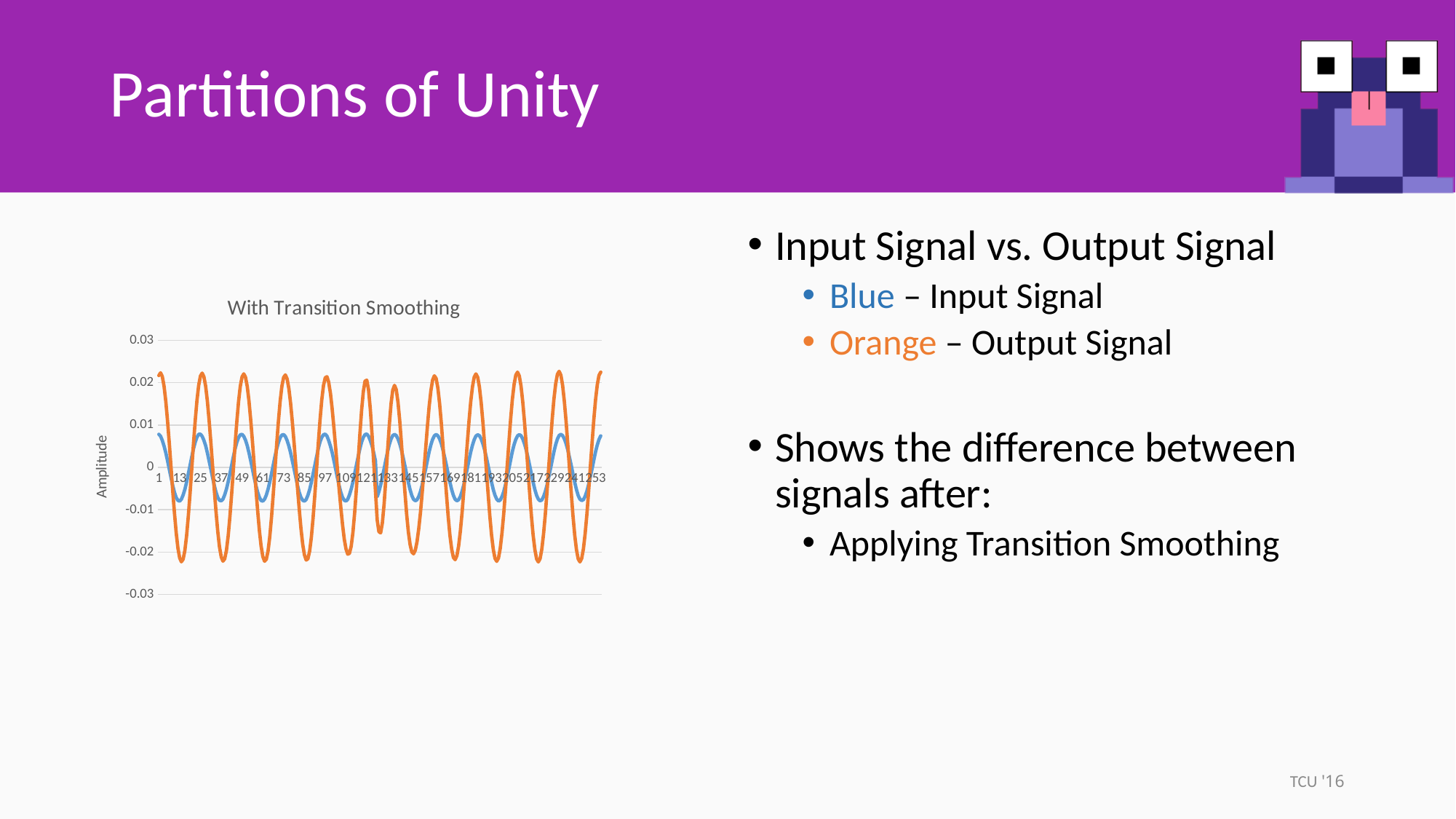
What is the title of the chart? With Transition Smoothing Are the peak values of the orange line greater or less than 0.02? greater Do the plotted values rise steadily, fall steadily, or oscillate along the x axis? oscillate Are the peak values of the orange line greater or less than 0.03? less How many lines (data series) are plotted on the chart? 2 Which line has the smaller amplitude, the blue line or the orange line? blue What kind of chart is shown on the slide? line chart Are the peak values of the blue line greater or less than 0.01? less What is the label on the vertical axis of the chart? Amplitude Which line reaches higher peaks, the blue line or the orange line? orange